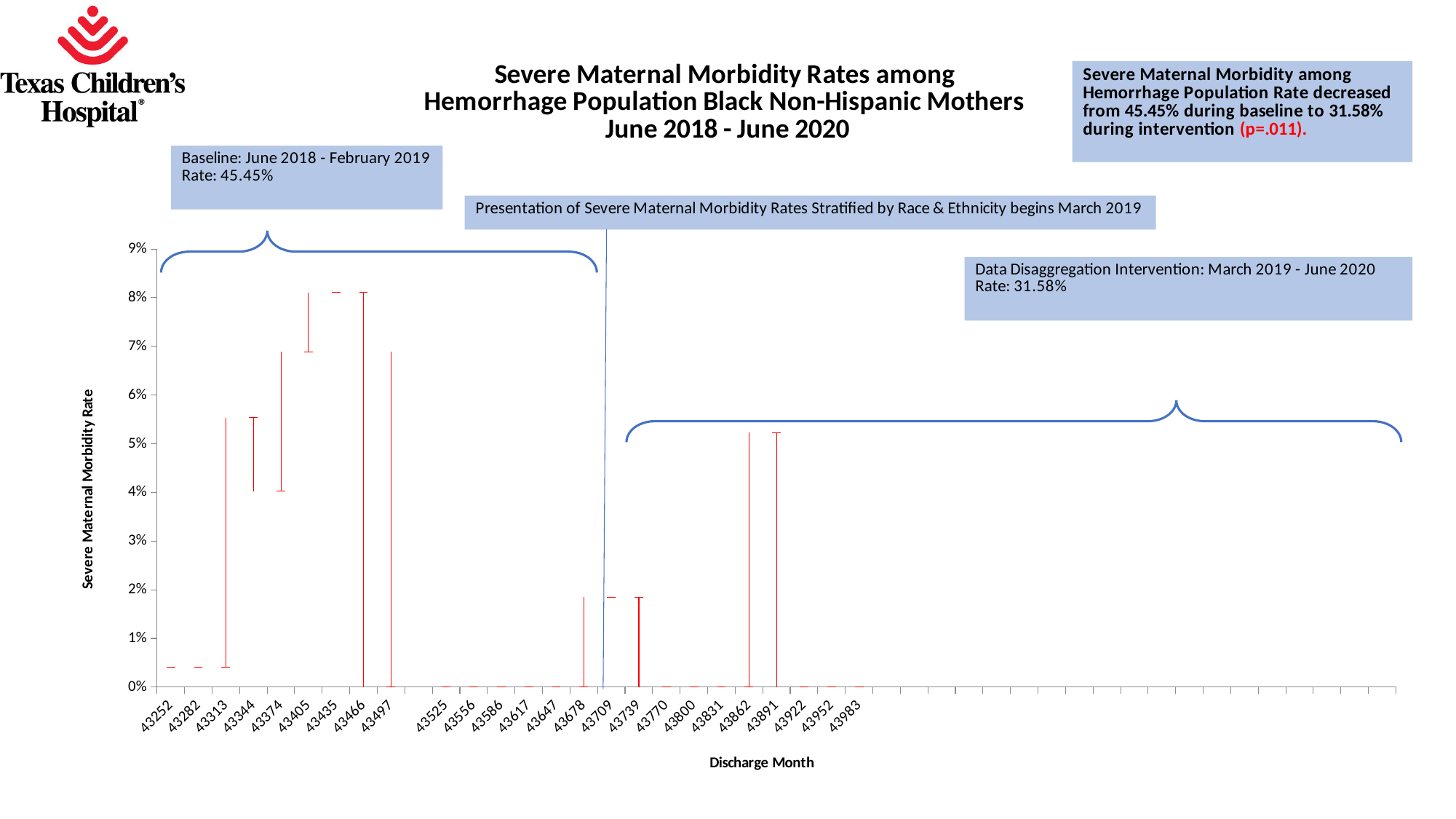
Is the highest value shown at 43497 greater or less than 8%? less Is the value shown at 43252 greater or less than 1%? less Is the highest value shown at 43466 greater or less than 7%? greater Which reaches a higher value on the chart, 43497 or 43678? 43497 How many labelled categories are shown on the x axis of the chart? 25 What is the title of the chart? Severe Maternal Morbidity Rates among Hemorrhage Population Black Non-Hispanic Mothers June 2018 - June 2020 Which reaches a higher value on the chart, 43466 or 43862? 43466 What is the label on the vertical axis of the chart? Severe Maternal Morbidity Rate